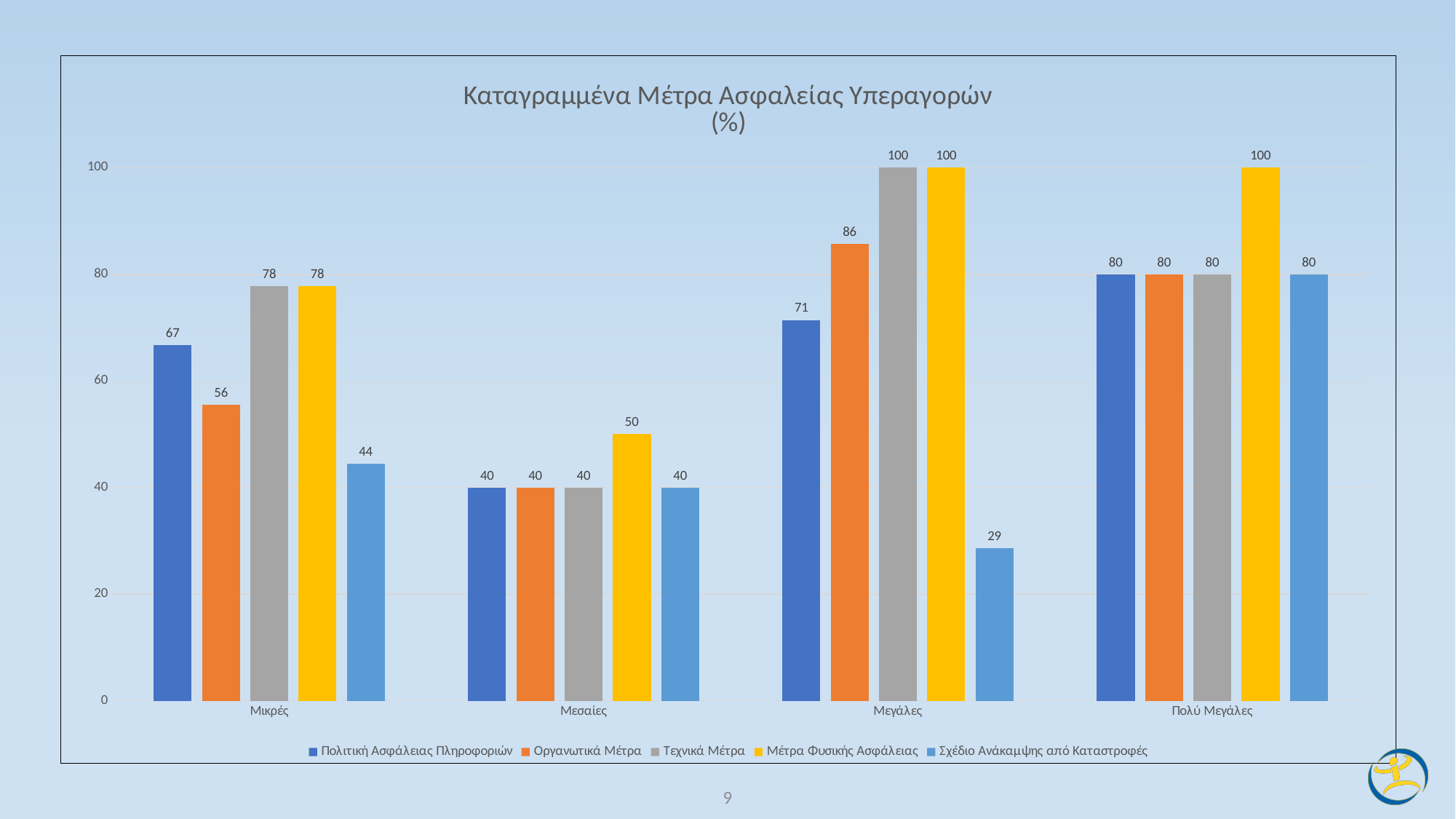
How many series does the legend list? 5 What is the value for Μέτρα Φυσικής Ασφάλειας in the Μεσαίες category? 50 Which colour represents Μέτρα Φυσικής Ασφάλειας in the legend? Yellow Which is larger: Τεχνικά Μέτρα in Μεγάλες or Τεχνικά Μέτρα in Πολύ Μεγάλες? Τεχνικά Μέτρα in Μεγάλες What is the difference between Οργανωτικά Μέτρα in Μεγάλες and Οργανωτικά Μέτρα in Μικρές? 30 What kind of chart is shown on the slide? Bar chart What is the title of the chart? Καταγραμμένα Μέτρα Ασφαλείας Υπεραγορών (%) What is the value for Πολιτική Ασφάλειας Πληροφοριών in the Μικρές category? 67 What is the value for Σχέδιο Ανάκαμψης από Καταστροφές in the Μεγάλες category? 29 Which series has the highest value in the Μεσαίες category? Μέτρα Φυσικής Ασφάλειας How many categories are shown on the x axis? 4 Which series has the lowest value in the Μικρές category? Σχέδιο Ανάκαμψης από Καταστροφές